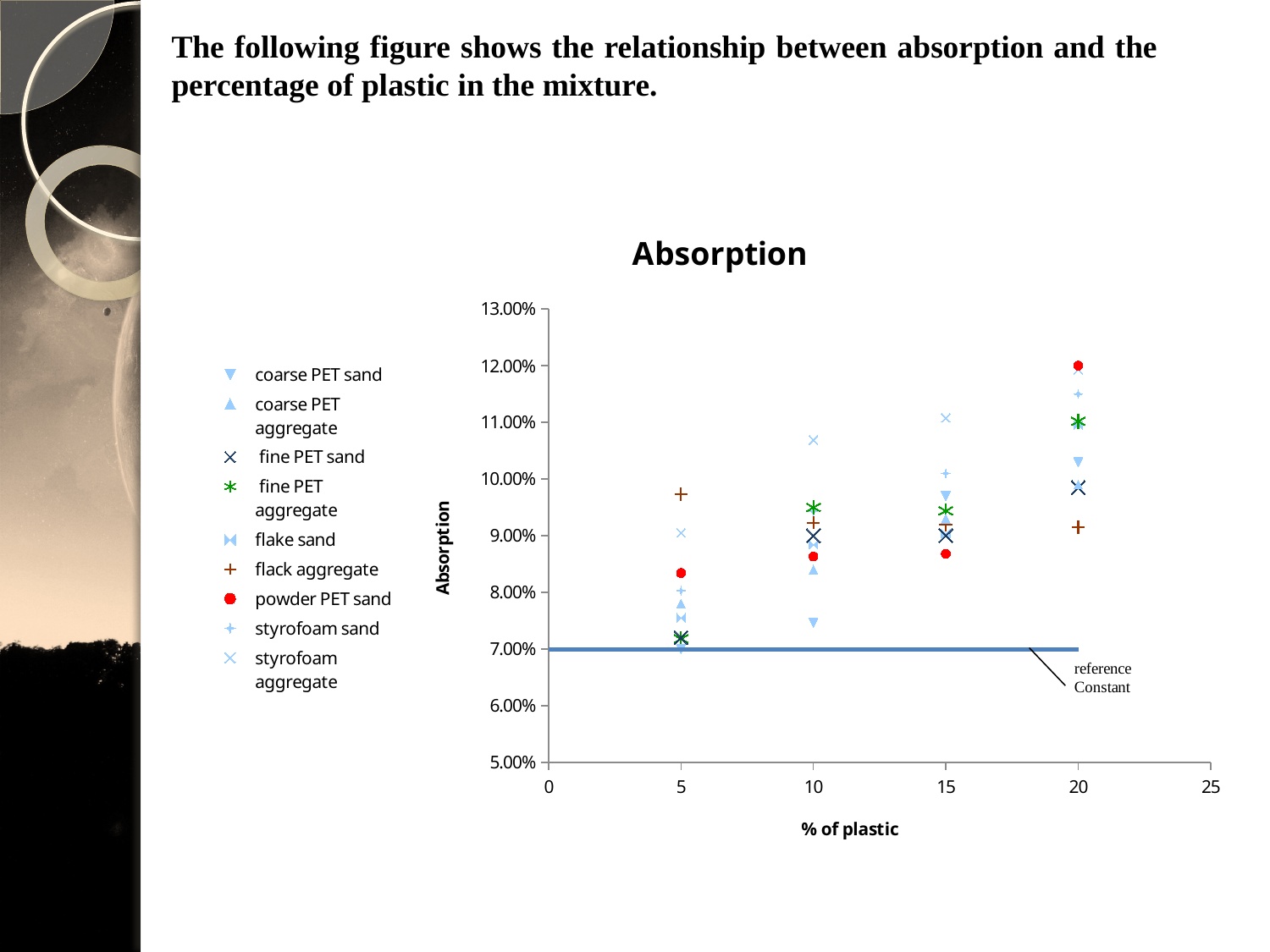
Does the absorption for powder PET sand rise or fall as the percentage of plastic increases? rise What kind of chart is shown on the slide? scatter chart Is the absorption value for styrofoam aggregate at 10% plastic greater or less than 10.00%? greater At how many different percentages of plastic are data points plotted? 4 Is the absorption value for flack aggregate at 5% plastic greater or less than 9.00%? greater Is the absorption value for coarse PET sand at 10% plastic greater or less than 8.00%? less At what absorption value is the reference Constant line drawn? 7.00% Does the absorption for flack aggregate rise or fall as the percentage of plastic increases? fall How many series does the legend list? 9 What is the label of the x axis? % of plastic